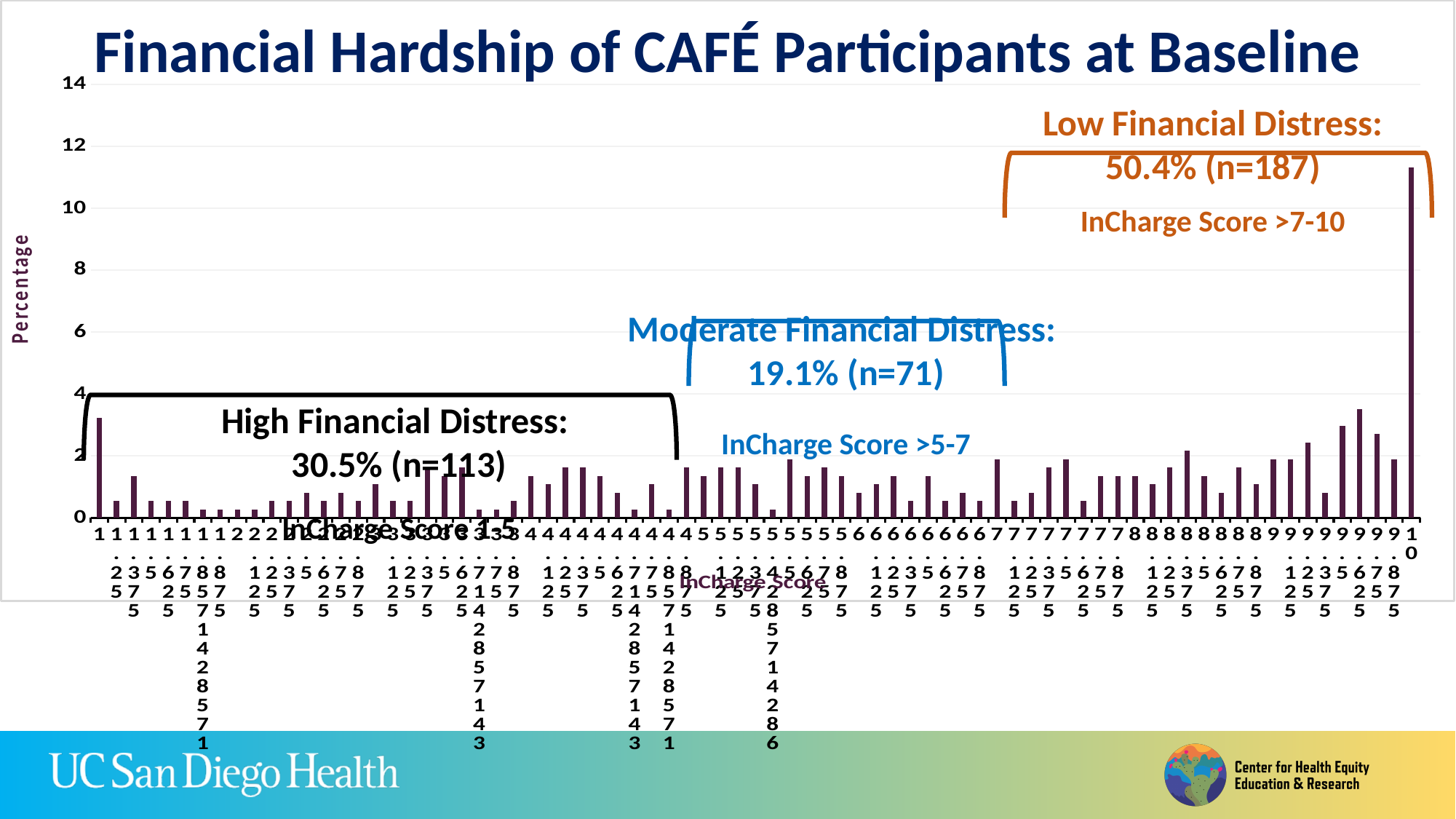
What is the title of the chart? Financial Hardship of CAFÉ Participants at Baseline Is the percentage for InCharge Score 10 greater or less than 10? greater What InCharge Score range defines the Low Financial Distress group? >7-10 Is the percentage for InCharge Score 1 greater or less than 2? greater What kind of chart is shown on the slide? Bar chart What is the label on the vertical axis of the chart? Percentage Is the percentage for InCharge Score 1 greater or less than 4? less What percentage of participants are in the Low Financial Distress group? 50.4% What percentage of participants are in the High Financial Distress group? 30.5% Which InCharge Score has the highest percentage of participants? 10 Which has a higher percentage, InCharge Score 1 or InCharge Score 10? InCharge Score 10 How many participants (n) are in the Moderate Financial Distress group? 71